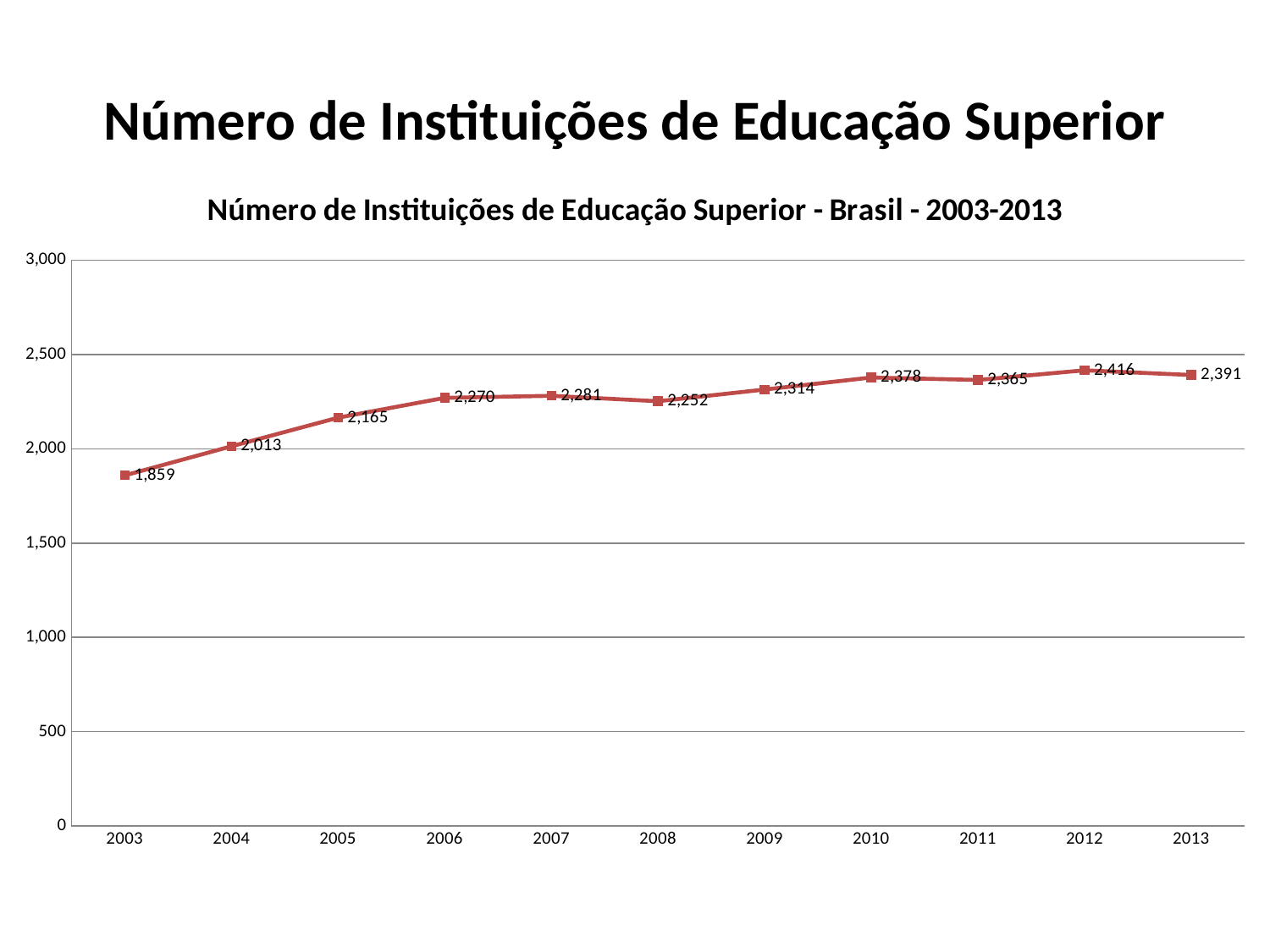
What is the chart's title? Número de Instituições de Educação Superior - Brasil - 2003-2013 What kind of chart is shown? line chart Which year has the lowest value? 2003 What is the value for 2003? 1,859 What is the value for 2008? 2,252 Is the value for 2005 greater or less than 2,000? greater Which year has the highest value? 2012 What is the difference between the values for 2012 and 2011? 51 What is the difference between the values for 2013 and 2003? 532 What is the value for 2013? 2,391 Which is larger, the value for 2007 or the value for 2008? 2007 How many years are plotted on the chart? 11